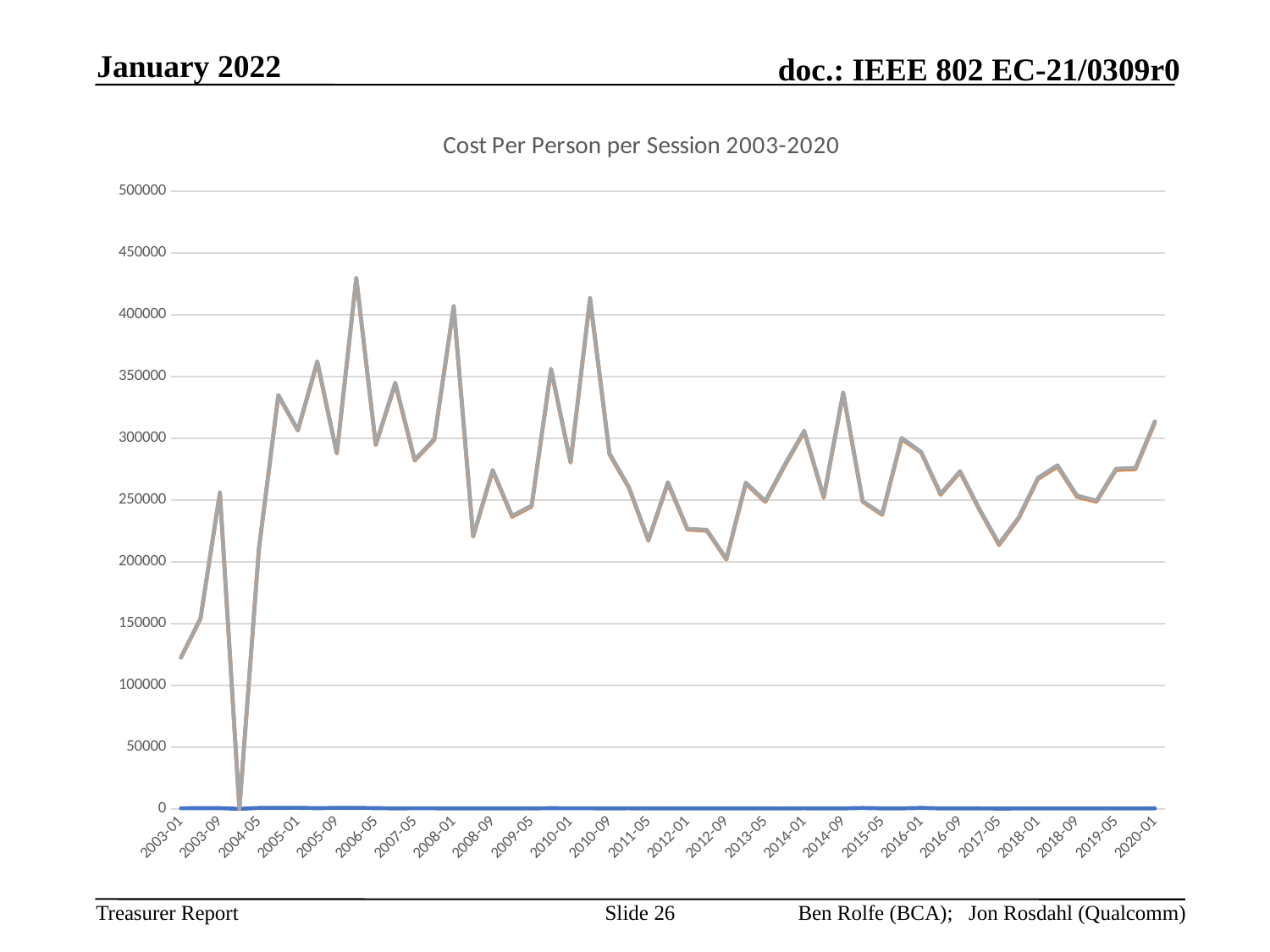
What kind of chart is shown on the slide? line chart Is the value for 2008-01 greater or less than 350000? greater Which has the larger value, 2003-01 or 2020-01? 2020-01 Is the value for 2014-09 greater or less than 300000? greater Which has the larger value, 2014-09 or 2017-05? 2014-09 What is the highest value shown on the vertical axis? 500000 Do the values rise or fall from 2017-05 to 2020-01? rise What is the title of the chart? Cost Per Person per Session 2003-2020 Is the value for 2003-01 greater or less than 150000? less